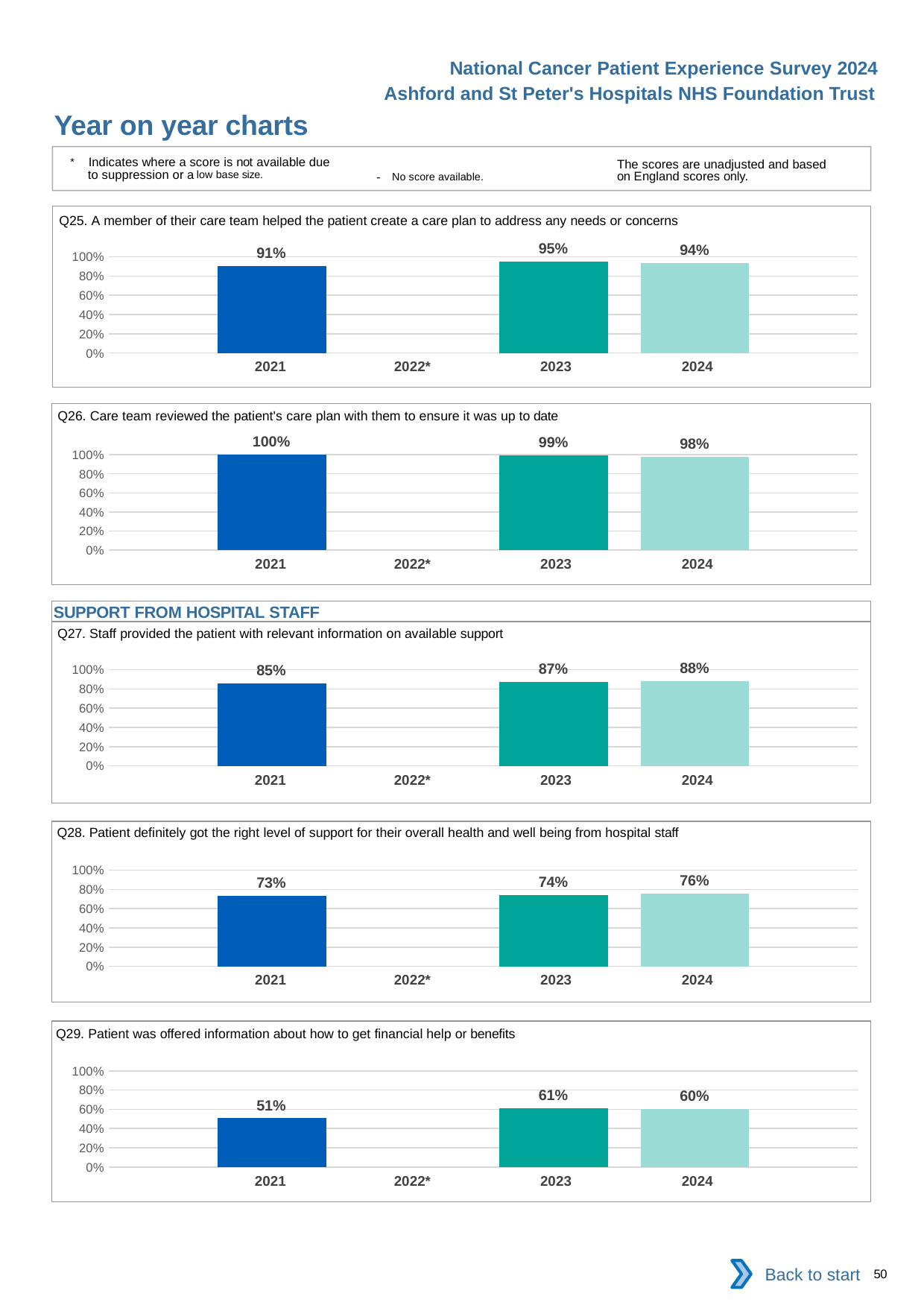
In the Q26 chart, what is the value for 2021? 100% In the Q25 chart, what is the value for 2023? 95% In the Q28 chart, what is the value for 2023? 74% In the Q25 chart, how many years have a bar plotted? 3 In the Q29 chart, which year has the lowest value? 2021 In the Q29 chart, is the value for 2023 larger or smaller than the value for 2024? larger In the Q29 chart, is the value for 2021 greater or less than 60%? less In the Q28 chart, what is the difference between the 2024 and 2021 values? 3% In the Q27 chart, do the values rise or fall from 2021 to 2024? rise What kind of chart is the Q26 chart? bar chart In the Q27 chart, which year has the highest value? 2024 Which year is marked with an asterisk on the x axis of the Q25 chart? 2022*